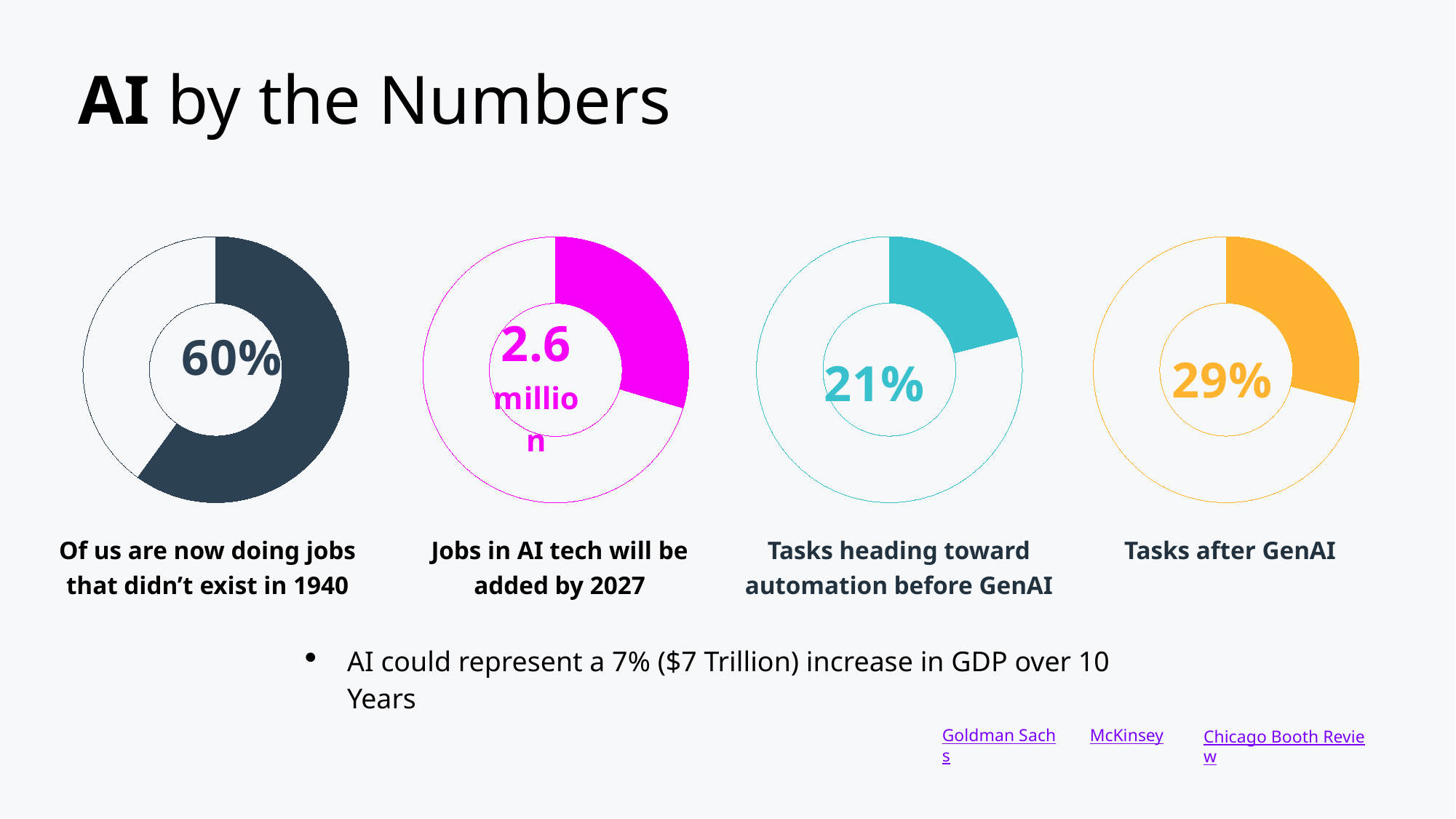
What value is shown in the donut chart labelled 'Tasks after GenAI'? 29% What colour is the filled segment of the rightmost donut chart? Orange What value is shown in the centre of the leftmost donut chart? 60% How many donut charts are shown on the slide? 4 What is the difference between the 'Tasks after GenAI' value and the 'Tasks heading toward automation before GenAI' value? 8 percentage points Among the three donut charts showing percentages, which has the highest value? Of us are now doing jobs that didn't exist in 1940 (60%) What is the caption under the leftmost donut chart? Of us are now doing jobs that didn't exist in 1940 What value is shown in the donut chart labelled 'Jobs in AI tech will be added by 2027'? 2.6 million What kind of chart is used for each of the four figures on the slide? Donut (pie) chart Which is larger: the share of tasks heading toward automation before GenAI or the share of tasks after GenAI? Tasks after GenAI Among the three donut charts showing percentages, which has the lowest value? Tasks heading toward automation before GenAI (21%) What value is shown in the donut chart labelled 'Tasks heading toward automation before GenAI'? 21%